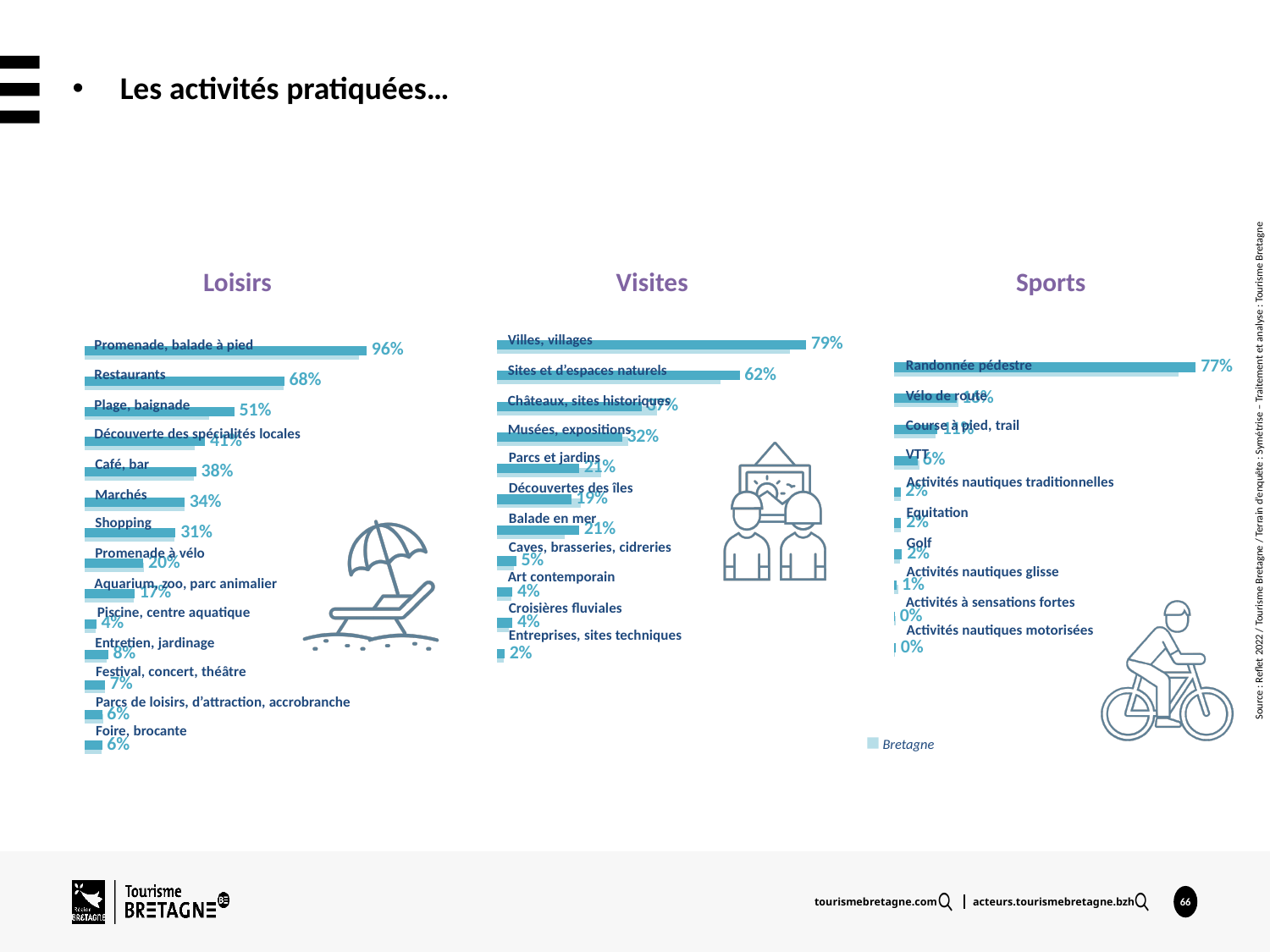
How many series does the legend of the Sports chart list? 1 In the Sports chart, what is the value for Randonnée pédestre? 77% How many categories does the Loisirs chart show? 14 In the Loisirs chart, which is larger: Marchés or Shopping? Marchés In the Sports chart, what is the value for Course à pied, trail? 11% What type of chart is the Visites chart? Bar chart In the Visites chart, what is the value for Musées, expositions? 32% In the Visites chart, what is the value for Villes, villages? 79% In the Loisirs chart, which activity has the highest value? Promenade, balade à pied In the Loisirs chart, what is the value for Restaurants? 68% In the Visites chart, which category has the lowest value? Entreprises, sites techniques In the Loisirs chart, what is the difference between Plage, baignade and Café, bar? 13%